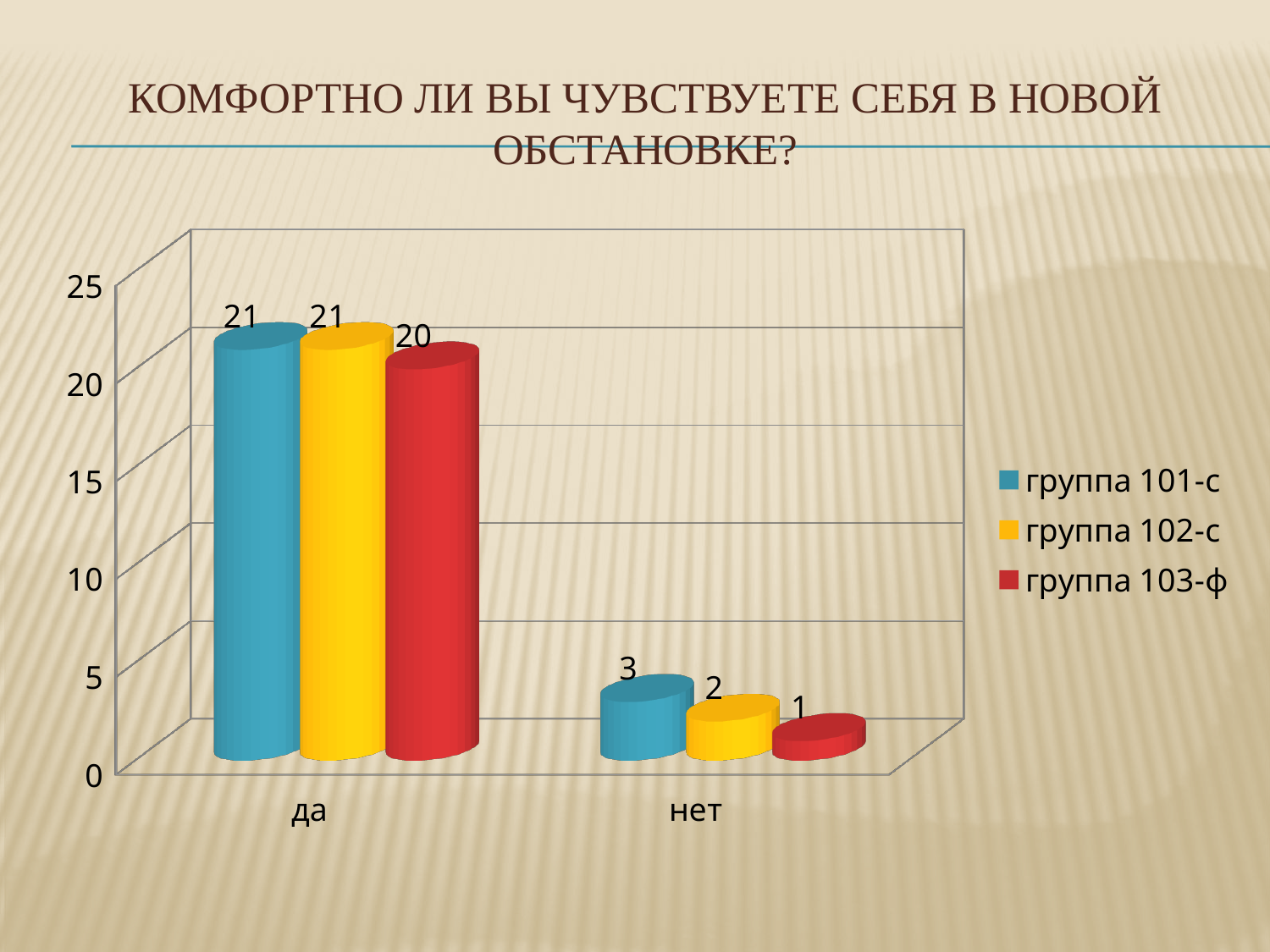
What is the value for группа 103-ф in the да category? 20 How many categories are shown on the x axis? 2 Which is larger: the нет value for группа 101-с or for группа 103-ф? группа 101-с What colour represents группа 102-с in the chart? yellow What is the value for группа 102-с in the нет category? 2 What is the value for группа 103-ф in the нет category? 1 Which series has the lowest value in the нет category? группа 103-ф What is the difference between the да and нет values for группа 101-с? 18 What is the value for группа 101-с in the да category? 21 How many series does the legend list? 3 What kind of chart is shown on the slide? bar chart What is the value for группа 101-с in the нет category? 3